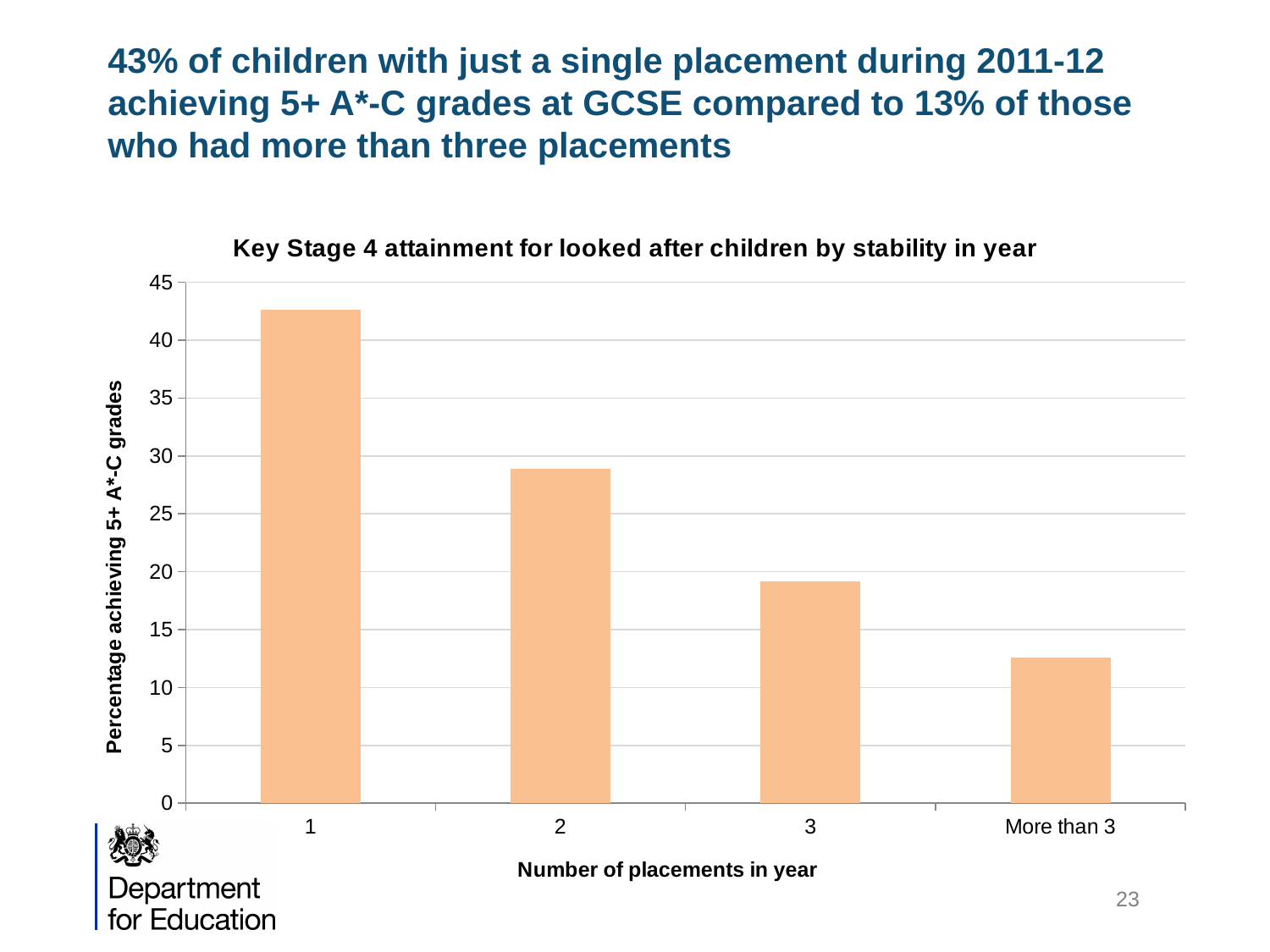
Which number of placements has the highest percentage achieving 5+ A*-C grades? 1 Is the value for 3 placements greater or less than 15? greater Is the value for 1 placement greater or less than 40? greater How many categories are shown on the x axis of the chart? 4 What kind of chart is shown on the slide? bar chart What is the title of the chart? Key Stage 4 attainment for looked after children by stability in year Do the values rise or fall as the number of placements increases along the x axis? fall Which number of placements has the lowest percentage achieving 5+ A*-C grades? More than 3 Is the value for More than 3 placements greater or less than 15? less Which is larger, the value for 2 placements or the value for 3 placements? 2 placements What is the label of the x axis? Number of placements in year